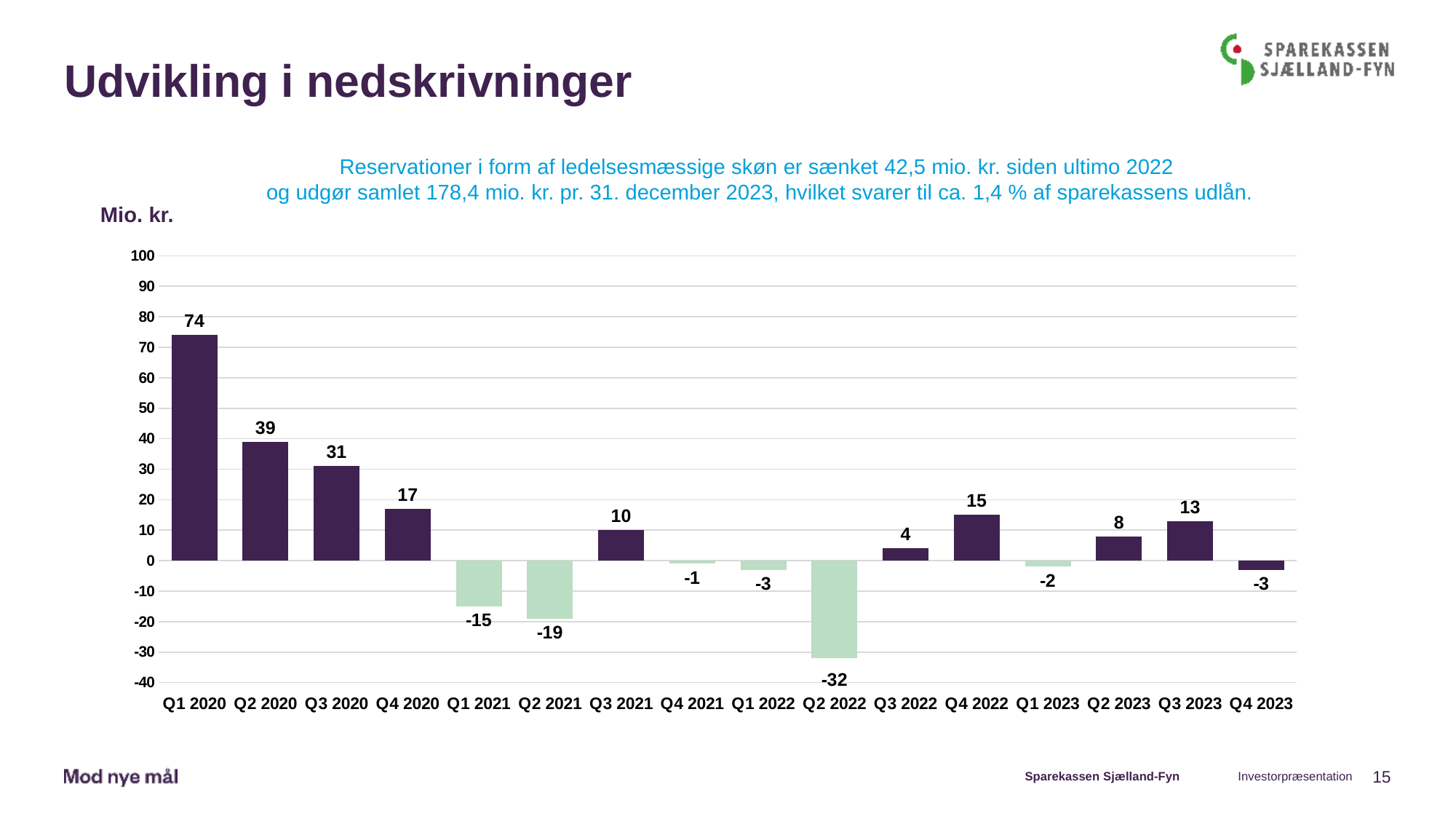
What kind of chart is shown on the slide? bar chart What unit label is shown above the y axis? Mio. kr. What is the value for Q4 2023? -3 What is the difference between the values for Q1 2020 and Q2 2020? 35 Which is larger, the value for Q4 2022 or the value for Q3 2023? Q4 2022 Do the values rise or fall from Q1 2020 to Q4 2020? fall Is the value for Q3 2020 greater or less than 40? less What is the value for Q1 2020? 74 How many quarters are shown on the x axis? 16 Which quarter has the lowest value? Q2 2022 Which quarter has the highest value? Q1 2020 What is the value for Q2 2022? -32